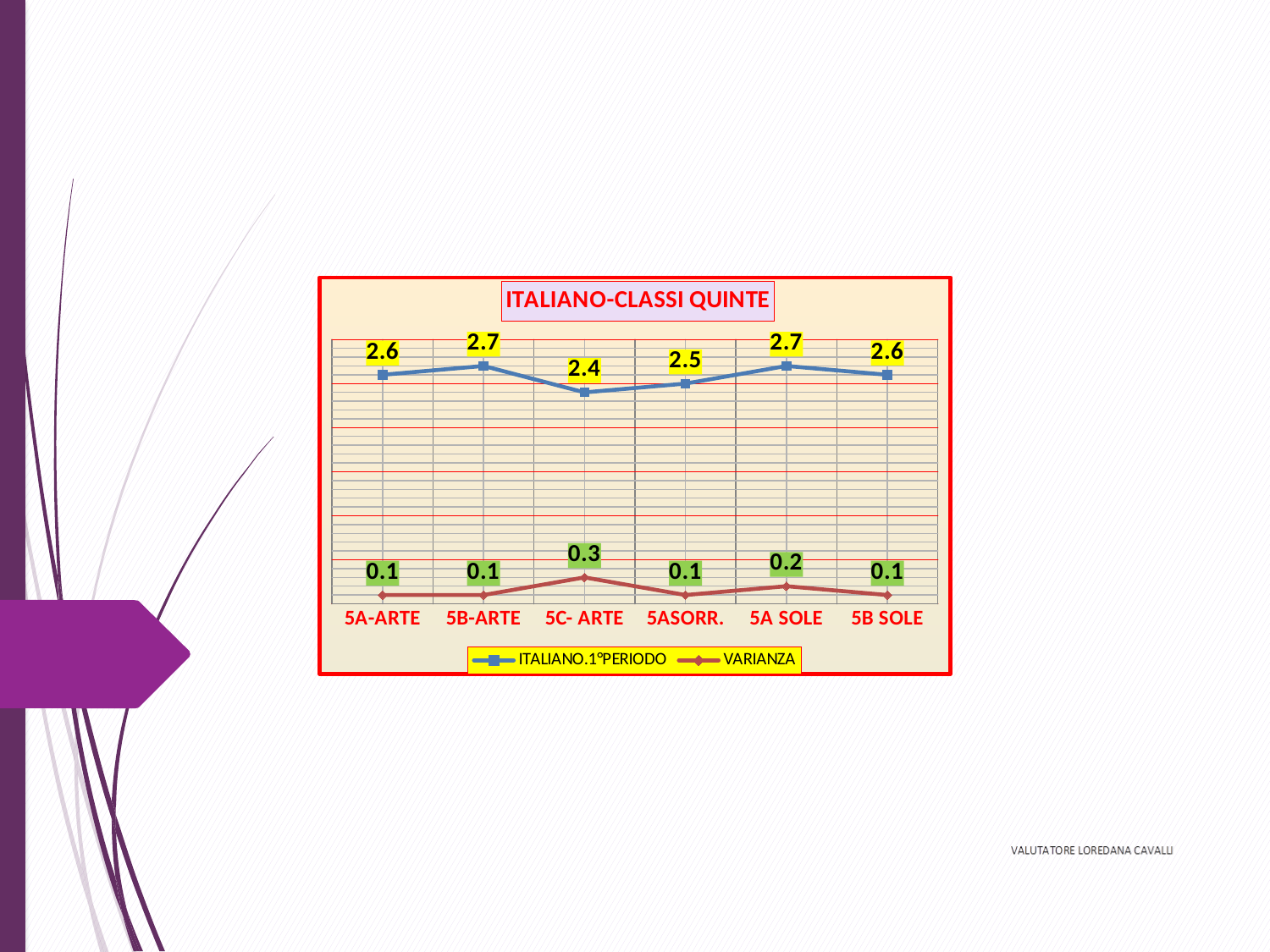
What is the VARIANZA value for 5A SOLE? 0.2 Which category has the lowest ITALIANO.1°PERIODO value? 5C- ARTE What kind of chart is shown on the slide? line chart Which category has the highest VARIANZA value? 5C- ARTE What is the difference between the ITALIANO.1°PERIODO values for 5B-ARTE and 5C- ARTE? 0.3 What is the title of the chart? ITALIANO-CLASSI QUINTE What is the ITALIANO.1°PERIODO value for 5C- ARTE? 2.4 What colour is the VARIANZA line? red Which is larger, the VARIANZA for 5A SOLE or for 5B SOLE? 5A SOLE What is the ITALIANO.1°PERIODO value for 5ASORR.? 2.5 How many series does the legend list? 2 How many categories are shown on the x axis? 6